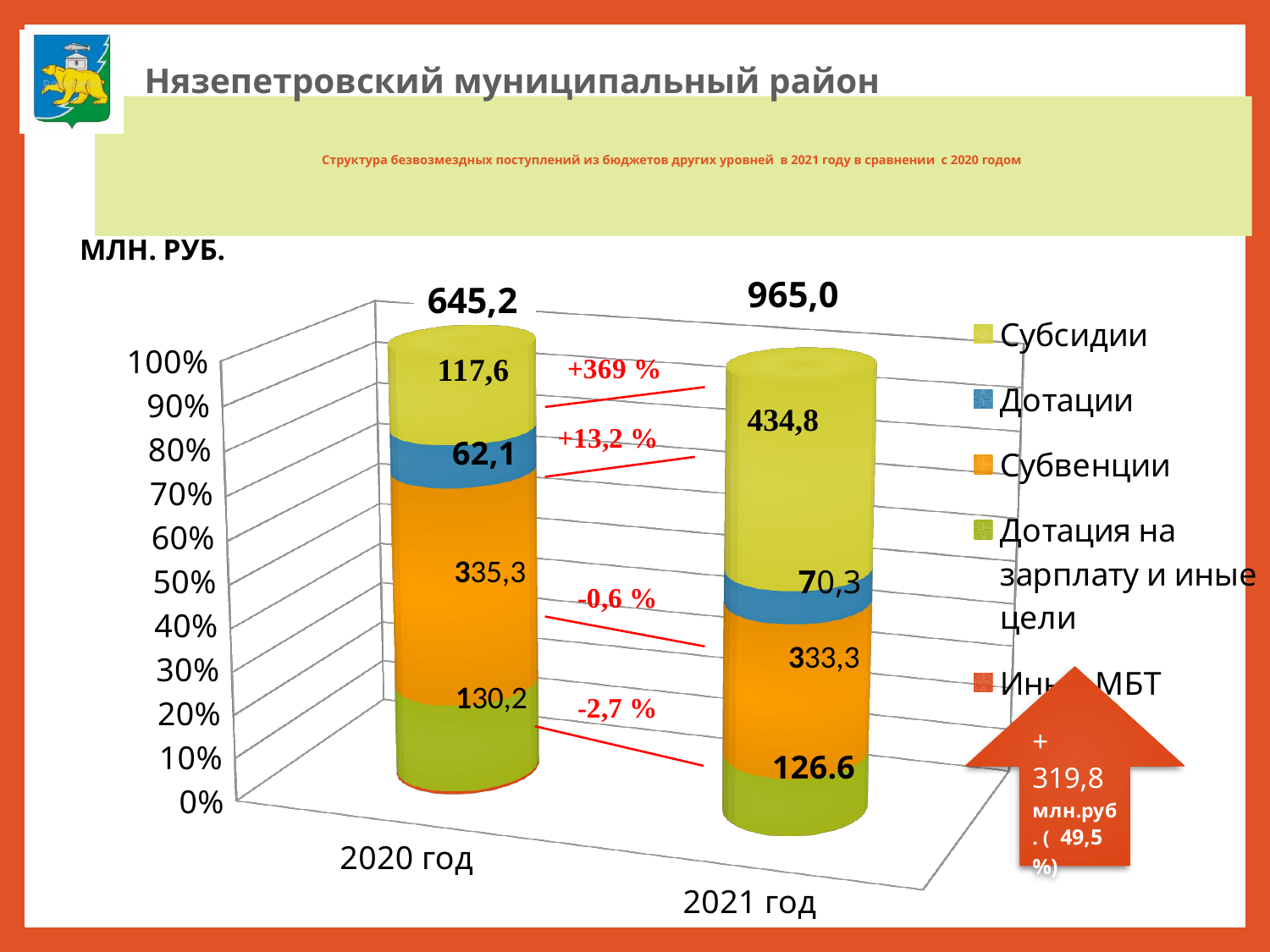
What is the difference between the totals for 2021 год and 2020 год? 319,8 Which segment is the largest in the 2020 год bar? Субвенции What kind of chart is shown on the slide? Stacked bar chart How many categories are shown on the x axis? 2 What is the value of Дотация на зарплату и иные цели for 2021 год? 126.6 What is the value of Субвенции for 2020 год? 335,3 What is the total shown above the bar for 2021 год? 965,0 Which year has the larger value for Субсидии, 2020 год or 2021 год? 2021 год How many series does the legend list? 5 What is the value of Дотации for 2020 год? 62,1 What is the total shown above the bar for 2020 год? 645,2 What is the value of Субсидии for 2021 год? 434,8